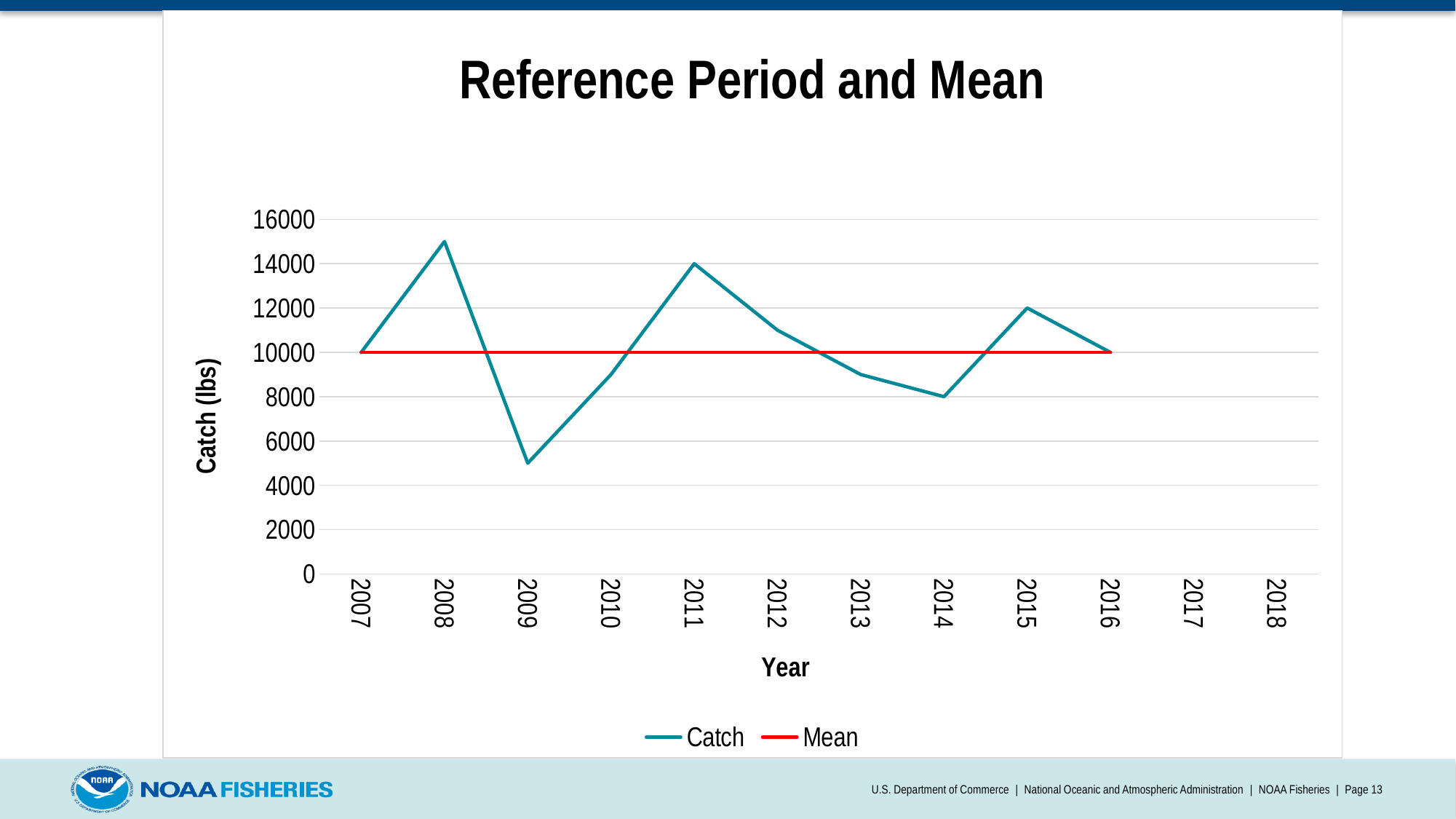
In which year is the Catch lowest? 2009 How many series does the legend list? 2 What is the title of the chart? Reference Period and Mean Is the Catch value for 2009 greater or less than 6000? less What kind of chart is shown on the slide? Line chart What is the Catch value for 2014? 8000 What is the difference between the Catch in 2015 and the Catch in 2014? 4000 In which year is the Catch highest? 2008 What is the Catch value for 2015? 12000 What is the value of the Mean line? 10000 What is the Catch value for 2011? 14000 Does the Catch rise or fall from 2011 to 2014? Fall